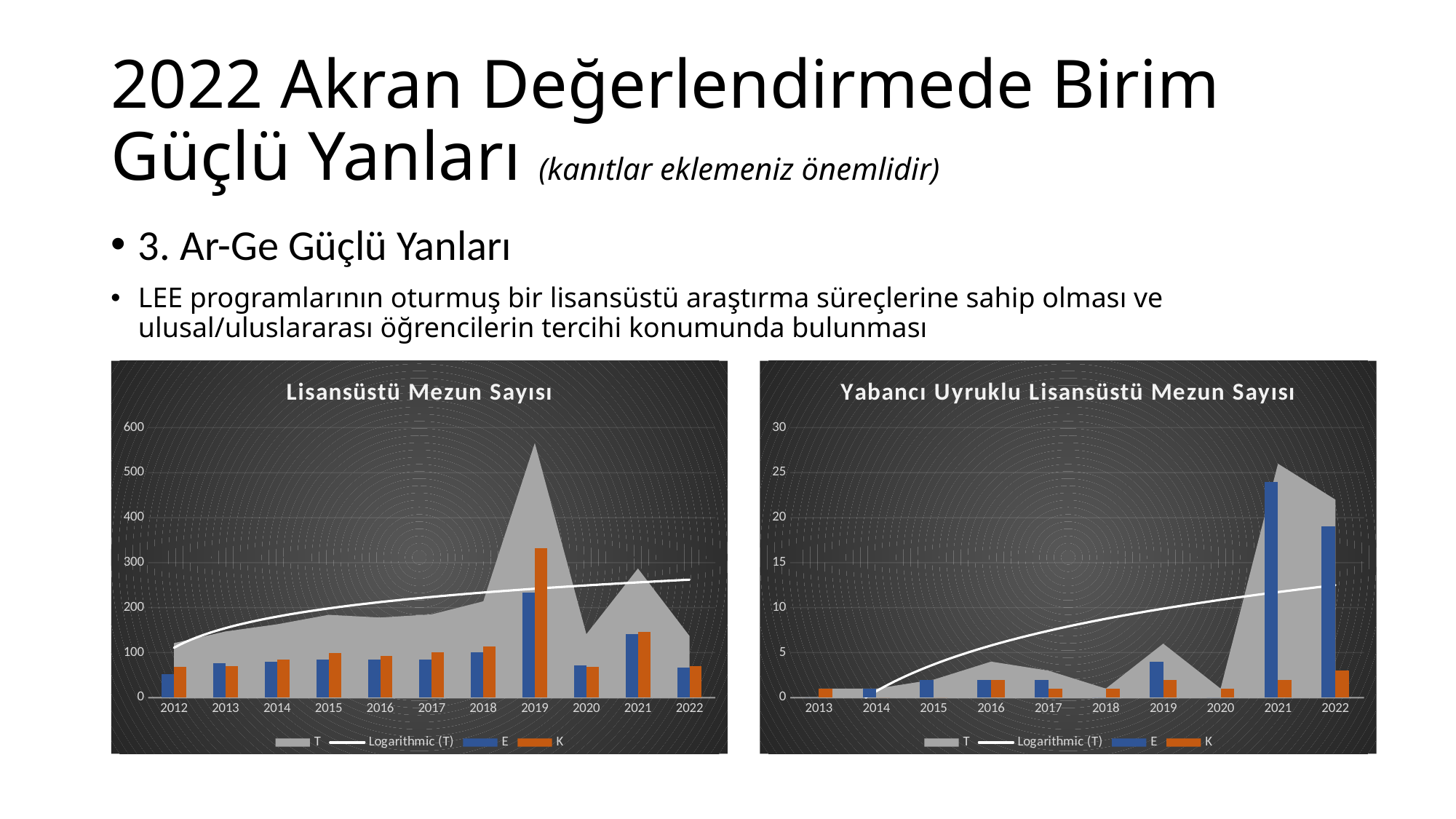
In the chart titled 'Lisansüstü Mezun Sayısı', is the T value for 2019 greater or less than 500? greater In the chart titled 'Lisansüstü Mezun Sayısı', is the K value for 2019 greater or less than 300? greater In the chart titled 'Lisansüstü Mezun Sayısı', in 2019 which is larger, the E bar or the K bar? K In the chart titled 'Yabancı Uyruklu Lisansüstü Mezun Sayısı', which year has the highest E bar? 2021 In the chart titled 'Lisansüstü Mezun Sayısı', how many years are shown on the x axis? 11 In the chart titled 'Lisansüstü Mezun Sayısı', which year has the highest E bar? 2019 In the chart titled 'Lisansüstü Mezun Sayısı', which year has the highest K bar? 2019 In the chart titled 'Lisansüstü Mezun Sayısı', how many entries does the legend list? 4 In the chart titled 'Yabancı Uyruklu Lisansüstü Mezun Sayısı', is the E value for 2021 greater or less than 20? greater What is the title of the chart on the right side of the slide? Yabancı Uyruklu Lisansüstü Mezun Sayısı In the chart titled 'Yabancı Uyruklu Lisansüstü Mezun Sayısı', in 2021 which is larger, the E bar or the K bar? E In the chart titled 'Yabancı Uyruklu Lisansüstü Mezun Sayısı', how many years are shown on the x axis? 10